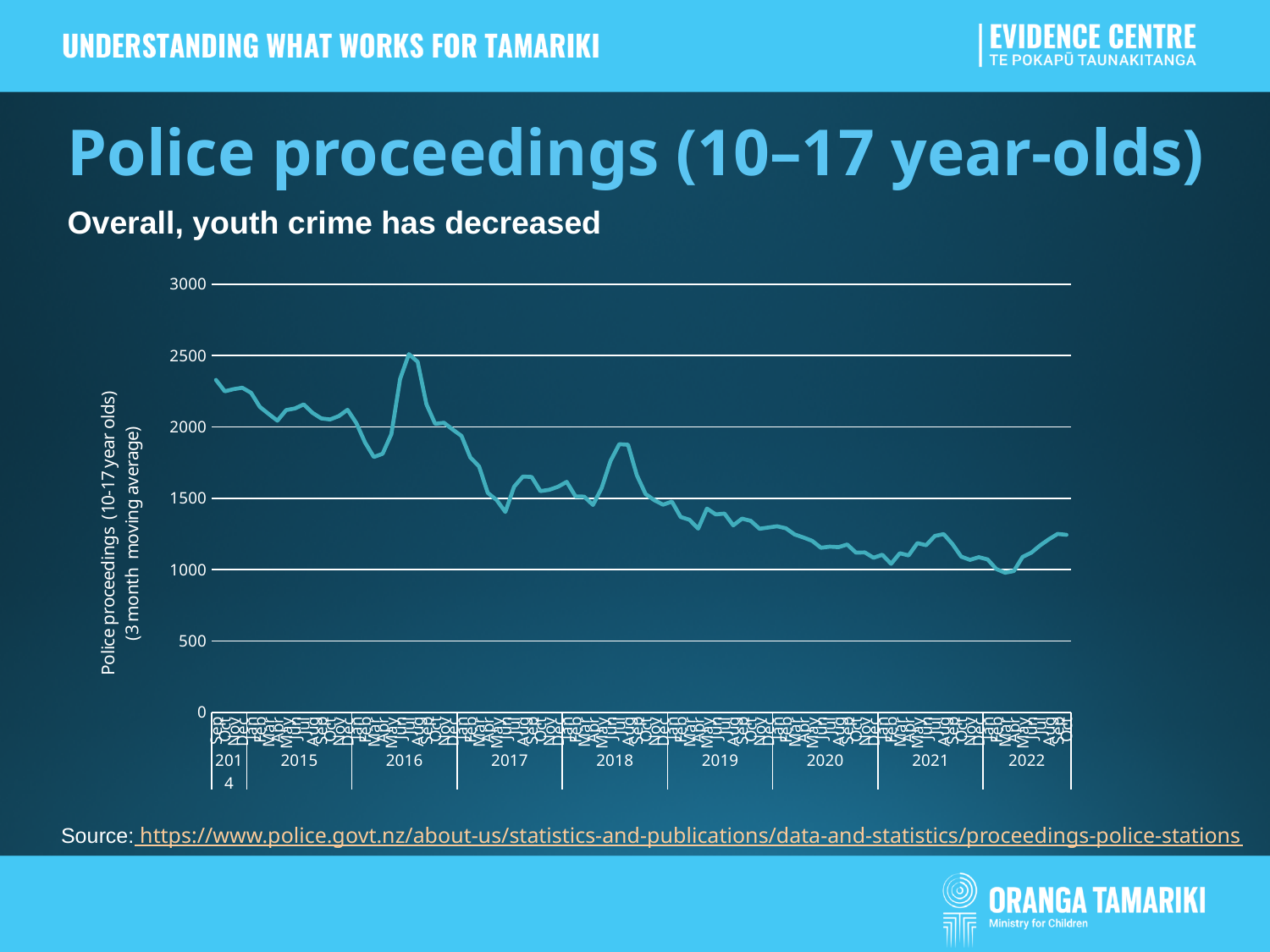
What is the highest value shown on the y axis? 3000 In which year does the line reach its highest peak? 2016 Which year has higher police proceedings, 2015 or 2020? 2015 What is the y-axis label of the chart? Police proceedings (10-17 year olds) (3 month moving average) Is the value during 2020 greater or less than 1500? less Which peak is higher, the one in 2016 or the one in 2018? 2016 Is the value at the start of 2014 greater or less than 2000? greater Overall, do police proceedings for 10–17 year-olds rise or fall from 2014 to 2022? fall What kind of chart is shown on the slide? line chart Is the peak value in 2016 greater or less than 2000? greater How many years are labelled on the x axis? 9